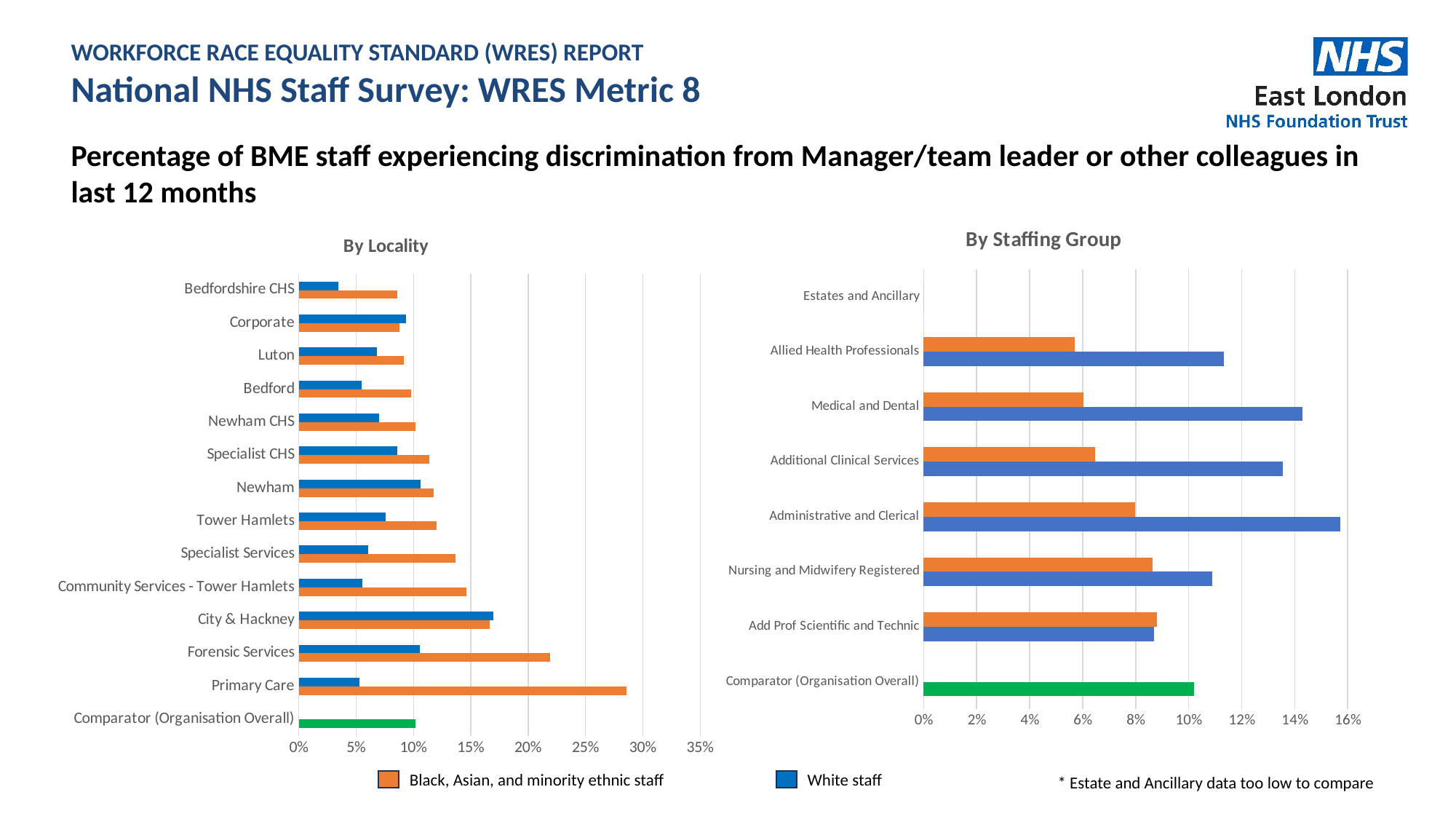
In the 'By Locality' chart, for Forensic Services, which is larger: the value for Black, Asian, and minority ethnic staff or for White staff? Black, Asian, and minority ethnic staff In the 'By Staffing Group' chart, which staffing group has no bars plotted? Estates and Ancillary In the 'By Locality' chart, is the value for Black, Asian, and minority ethnic staff in Primary Care greater or less than 25%? greater How many series does the shared legend list? 2 In the 'By Locality' chart, which locality has the lowest value for White staff? Bedfordshire CHS In the 'By Locality' chart, is the value for White staff in Primary Care greater or less than 10%? less In the 'By Staffing Group' chart, is the value for White staff in Additional Clinical Services greater or less than 12%? greater In the 'By Locality' chart, which locality has the highest value for Black, Asian, and minority ethnic staff? Primary Care In the 'By Locality' chart, which locality has the highest value for White staff? City & Hackney In the 'By Locality' chart, how many categories are shown on the vertical axis? 14 In the 'By Staffing Group' chart, which staffing group has the highest value for White staff? Administrative and Clerical What kind of chart is the 'By Locality' chart? bar chart